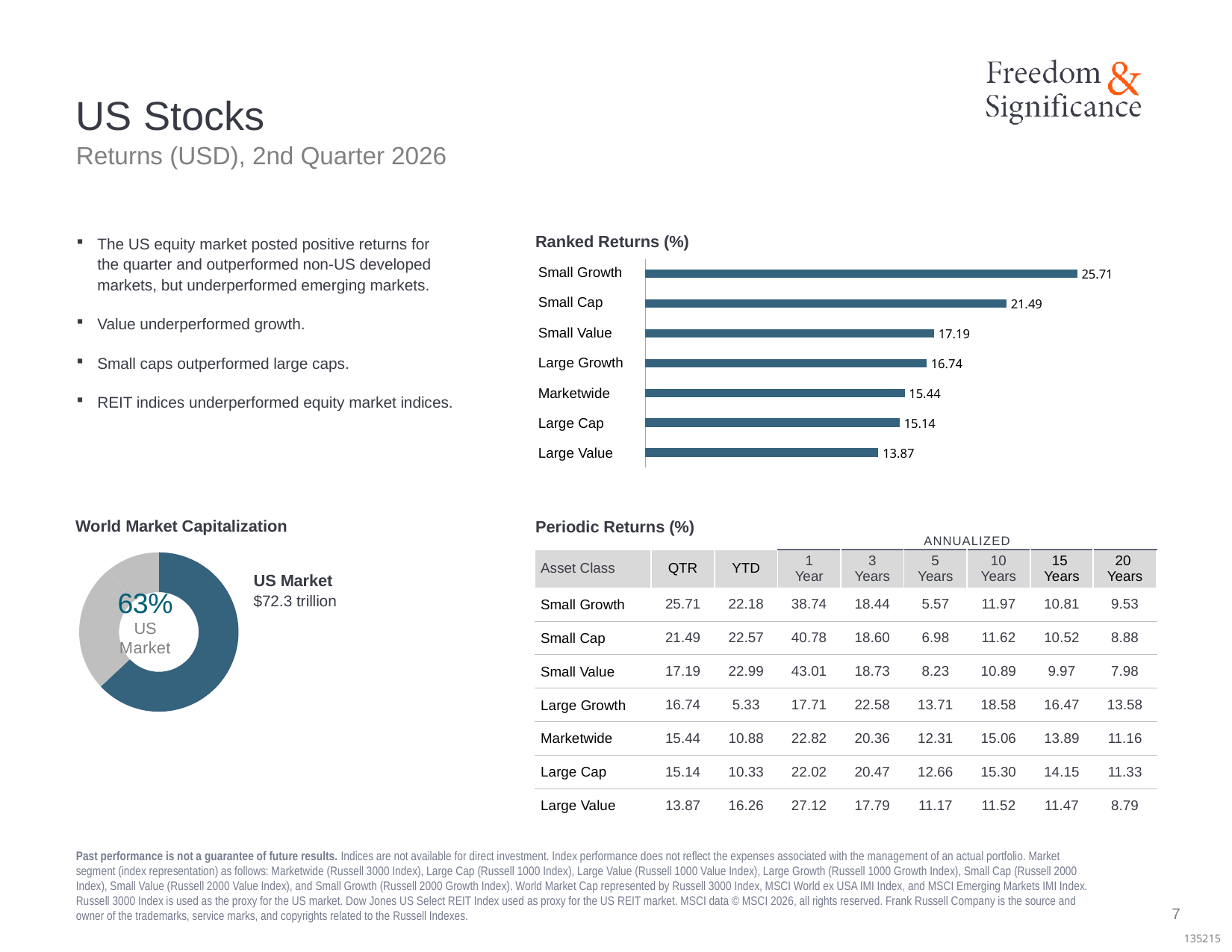
In the Ranked Returns (%) chart, which category has the highest value? Small Growth In the World Market Capitalization chart, what share of the world market does the US Market represent? 63% In the Ranked Returns (%) chart, what is the value for Large Value? 13.87 What kind of chart is the World Market Capitalization chart? Donut chart In the World Market Capitalization chart, what is the value of the US Market in dollars? $72.3 trillion What kind of chart is the Ranked Returns (%) chart? Bar chart How many categories are shown in the Ranked Returns (%) chart? 7 In the Ranked Returns (%) chart, what is the value for Small Growth? 25.71 In the Ranked Returns (%) chart, what is the value for Marketwide? 15.44 In the Ranked Returns (%) chart, which is larger, Small Value or Large Growth? Small Value In the Ranked Returns (%) chart, what is the difference between Small Cap and Large Cap? 6.35 In the Ranked Returns (%) chart, which category has the lowest value? Large Value